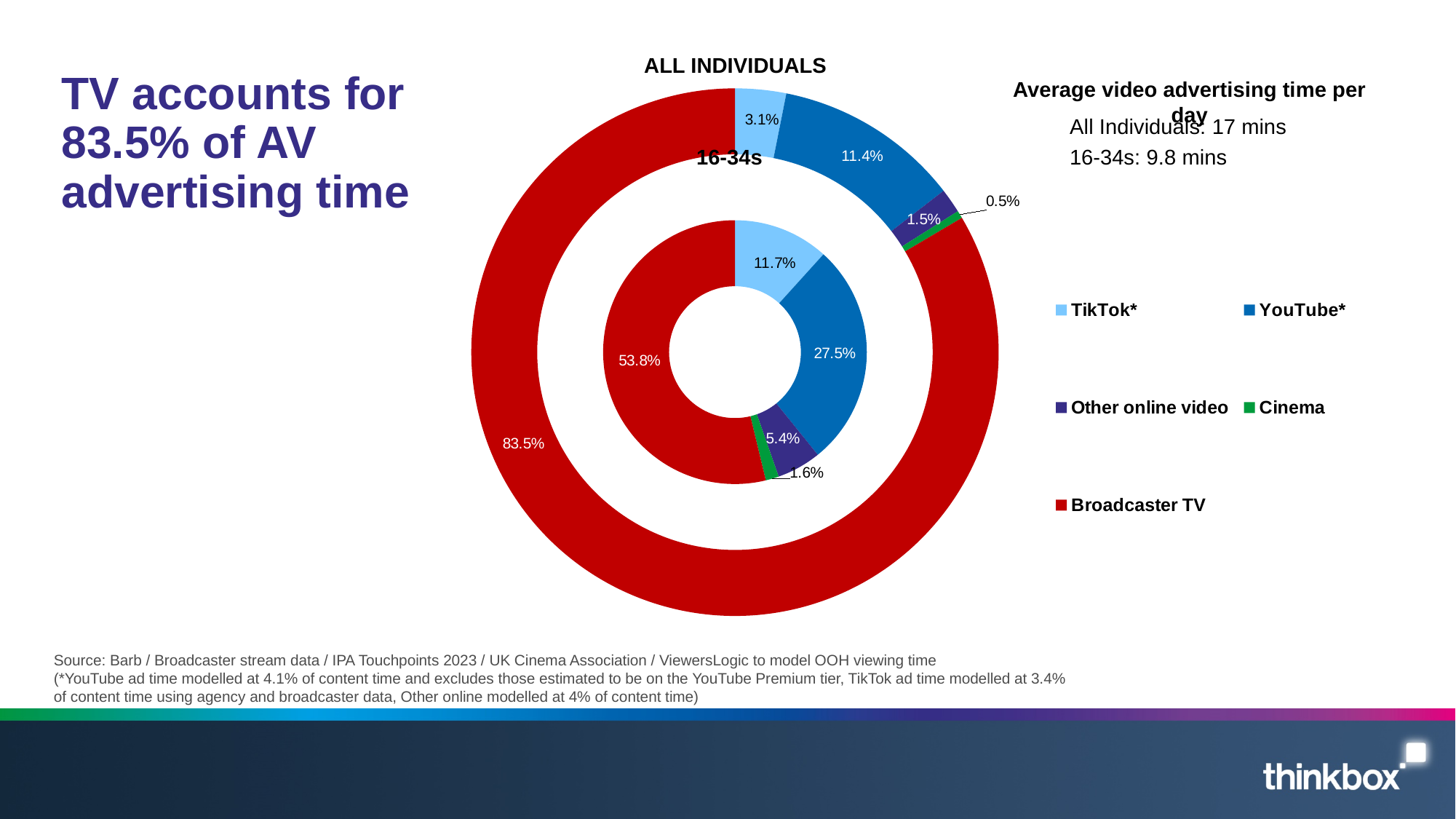
Which is larger: the YouTube* share for 16-34s or the YouTube* share for ALL INDIVIDUALS? 16-34s In the 16-34s ring, what is the value for Other online video? 5.4% In the 16-34s ring, what share does YouTube* account for? 27.5% In the 16-34s ring, what is the value for TikTok*? 11.7% In the ALL INDIVIDUALS ring, what is the value for Cinema? 0.5% What is the difference between the Broadcaster TV share for ALL INDIVIDUALS and for 16-34s? 29.7% In the ALL INDIVIDUALS ring, what share of AV advertising time does Broadcaster TV account for? 83.5% Which colour represents Broadcaster TV in the chart? Red Which category has the largest share in the 16-34s ring? Broadcaster TV Which category has the smallest share in the ALL INDIVIDUALS ring? Cinema How many categories does the legend list? 5 What kind of chart is shown on the slide? Doughnut chart